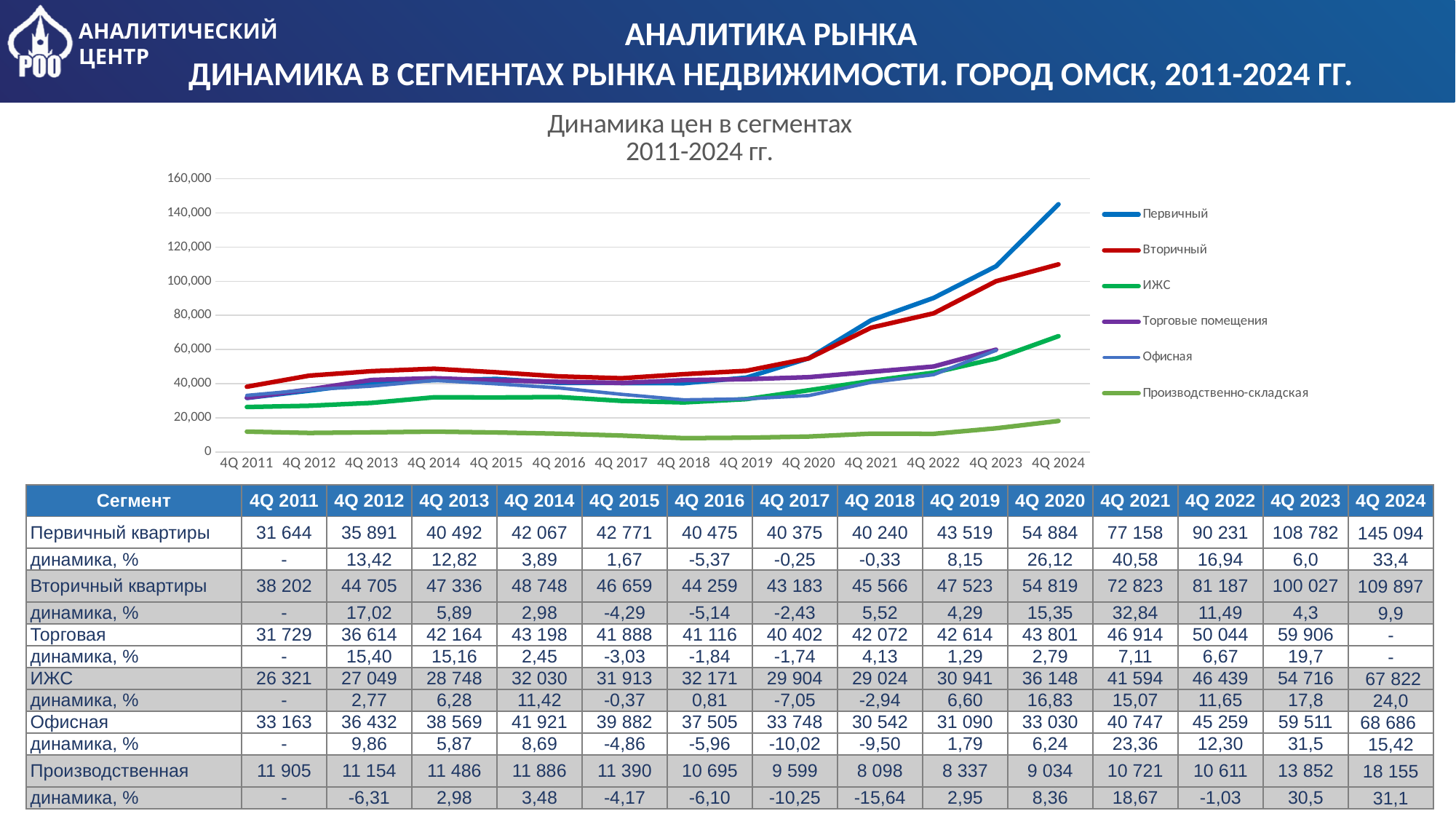
Is the value for Первичный at 4Q 2024 greater or less than 140,000? greater What is the value for Первичный квартиры at 4Q 2024 according to the table? 145 094 How many series does the chart legend list? 6 What kind of chart is shown on the slide? line chart Does the Первичный line rise or fall from 4Q 2019 to 4Q 2024? rises What is the title of the chart? Динамика цен в сегментах 2011-2024 гг. How many quarters are plotted along the x axis of the chart? 14 Which series has the lowest values across the whole period? Производственно-складская Which series has the highest value at 4Q 2024? Первичный At 4Q 2011, which is larger: Первичный or Вторичный? Вторичный Is the value for Вторичный at 4Q 2024 greater or less than 100,000? greater Is the value for Производственно-складская at 4Q 2024 greater or less than 20,000? less